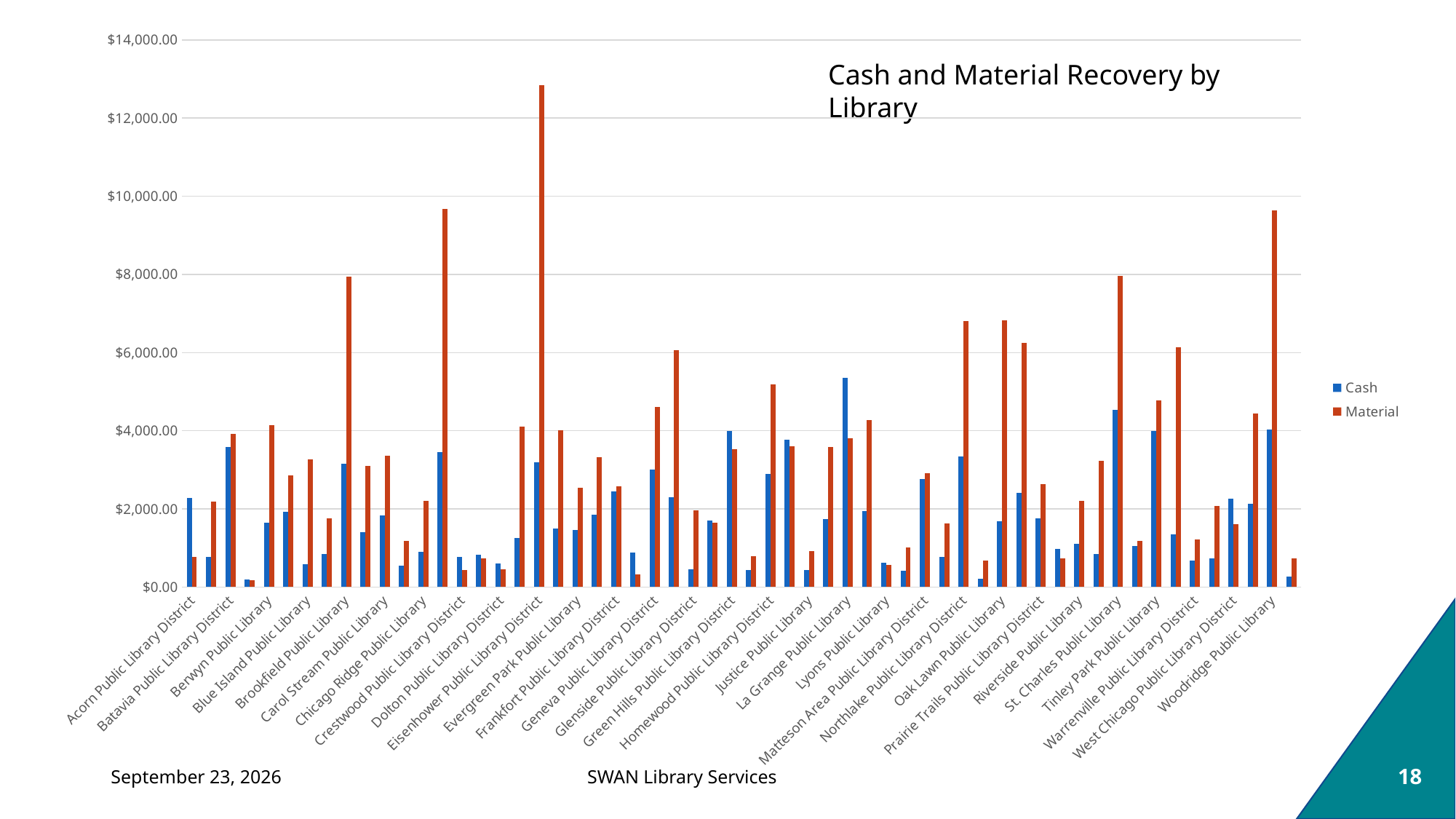
Is the Material value for Acorn Public Library District greater or less than $1,000.00? less Which library has the highest Cash value? La Grange Public Library For Homewood Public Library District, which is larger, Cash or Material? Material Which series is shown in blue in the legend? Cash Is the Material value for Northlake Public Library District greater or less than $6,000.00? greater Is the Material value for Eisenhower Public Library District greater or less than $12,000.00? greater Which library has the highest Material value? Eisenhower Public Library District For Acorn Public Library District, which is larger, Cash or Material? Cash How many series does the legend list? 2 What kind of chart is shown on the slide? Bar chart What is the title of the chart? Cash and Material Recovery by Library